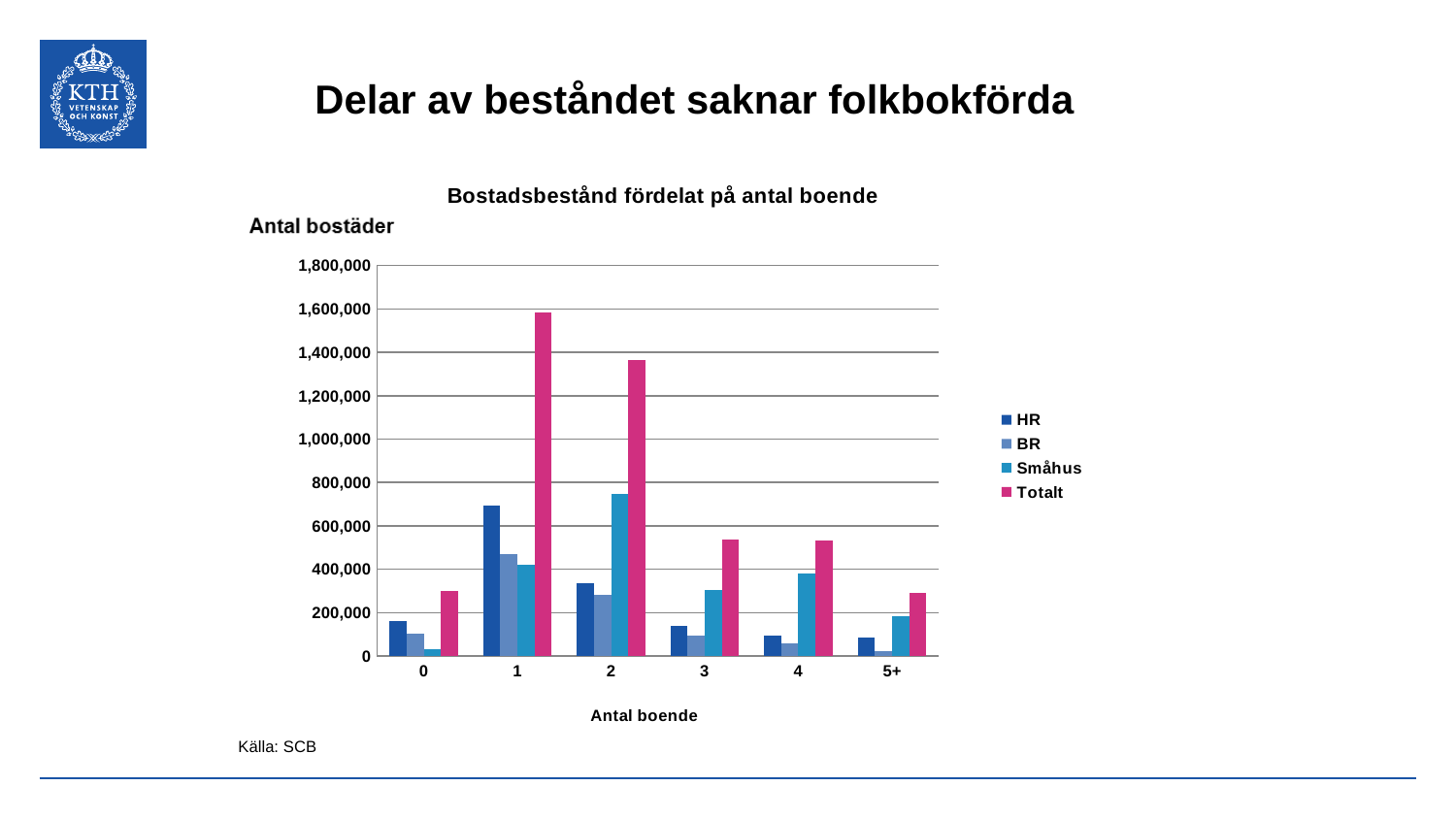
For which Antal boende category is the Småhus bar highest? 2 Is the HR value for category 1 greater or less than 600,000? greater How many categories are shown on the x axis (Antal boende)? 6 For category 0, which is larger: HR or Småhus? HR For category 4, which is larger: Småhus or HR? Småhus What kind of chart is shown on the slide? bar chart For which Antal boende category is the BR bar lowest? 5+ How many series does the legend list? 4 Is the Totalt value for category 1 greater or less than 1,400,000? greater For which Antal boende category is the Totalt bar highest? 1 Does the Totalt series rise or fall from category 1 to category 5+? fall Is the Småhus value for category 2 greater or less than 800,000? less